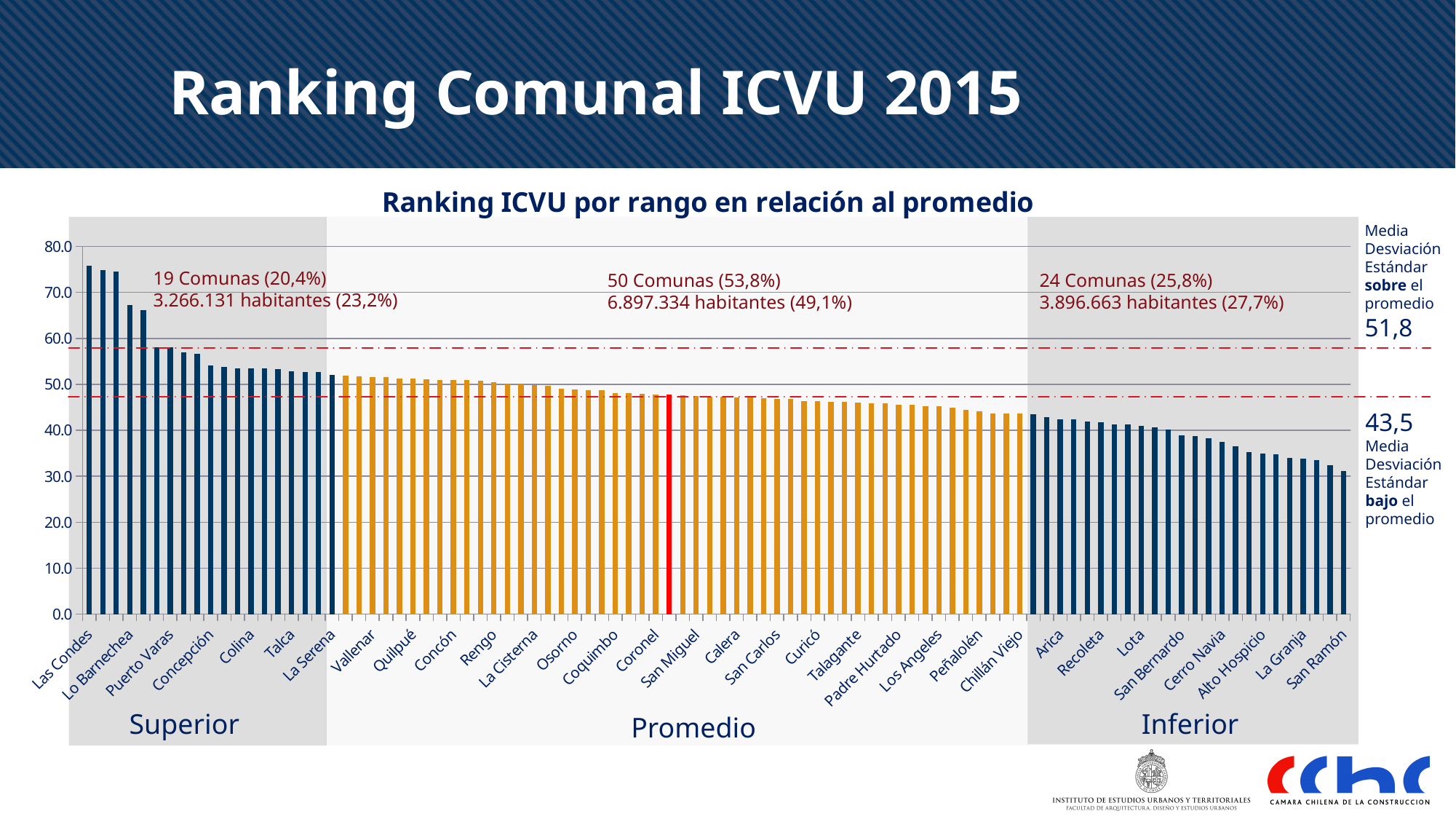
Which is larger, the value for Las Condes or the value for San Ramón? Las Condes What value is given for the upper reference line (Media + Desviación Estándar sobre el promedio)? 51,8 Which comuna has the lowest value in the chart? San Ramón Is the value for Arica greater or less than 50? less How many comunas are in the Promedio group according to the chart annotation? 50 Which comuna has the highest value in the chart? Las Condes Is the value for San Ramón greater or less than 40? less What is the title of the chart? Ranking ICVU por rango en relación al promedio How many comunas are in the Superior group according to the chart annotation? 19 Do the bar values rise or fall from left to right along the x axis? fall What kind of chart is shown on the slide? bar chart Is the value for Las Condes greater or less than 70? greater